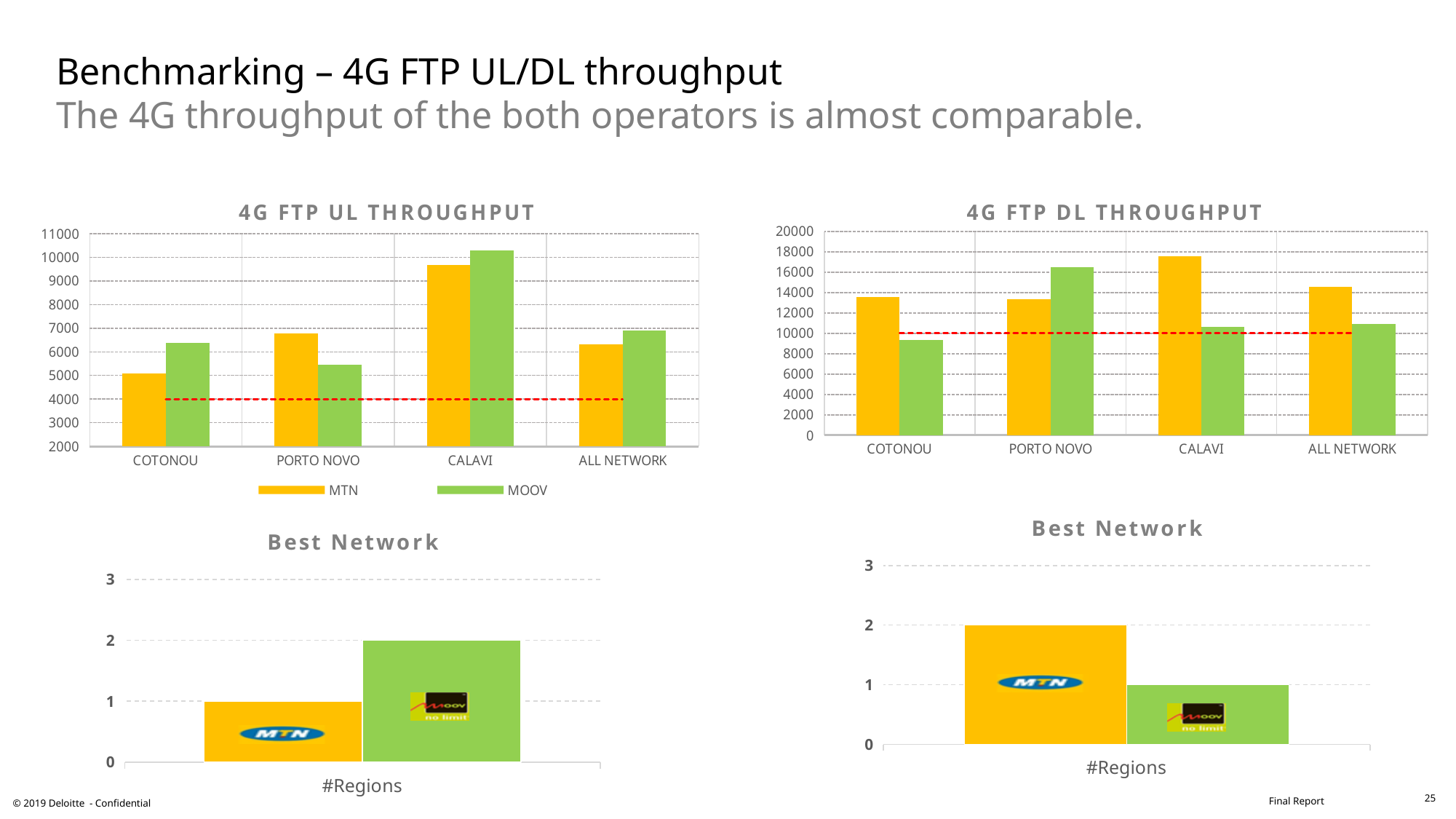
In the 4G FTP DL THROUGHPUT chart, is the MOOV value for COTONOU greater or less than 10000? less In the 4G FTP UL THROUGHPUT chart, for COTONOU, which is larger: MTN or MOOV? MOOV In the 4G FTP UL THROUGHPUT chart, which category has the lowest MTN value? COTONOU In the Best Network chart at the bottom left of the slide, what is the value for MOOV? 2 In the 4G FTP UL THROUGHPUT chart, is the MTN value for CALAVI greater or less than 9000? greater In the 4G FTP DL THROUGHPUT chart, which category has the lowest MOOV value? COTONOU How many categories are shown on the x axis of the 4G FTP DL THROUGHPUT chart? 4 In the 4G FTP UL THROUGHPUT chart, which category has the highest MTN value? CALAVI In the 4G FTP DL THROUGHPUT chart, for CALAVI, which is larger: MTN or MOOV? MTN How many series does the legend of the 4G FTP UL THROUGHPUT chart list? 2 What kind of chart is the 4G FTP UL THROUGHPUT chart? bar chart In the 4G FTP DL THROUGHPUT chart, which category has the highest MOOV value? PORTO NOVO